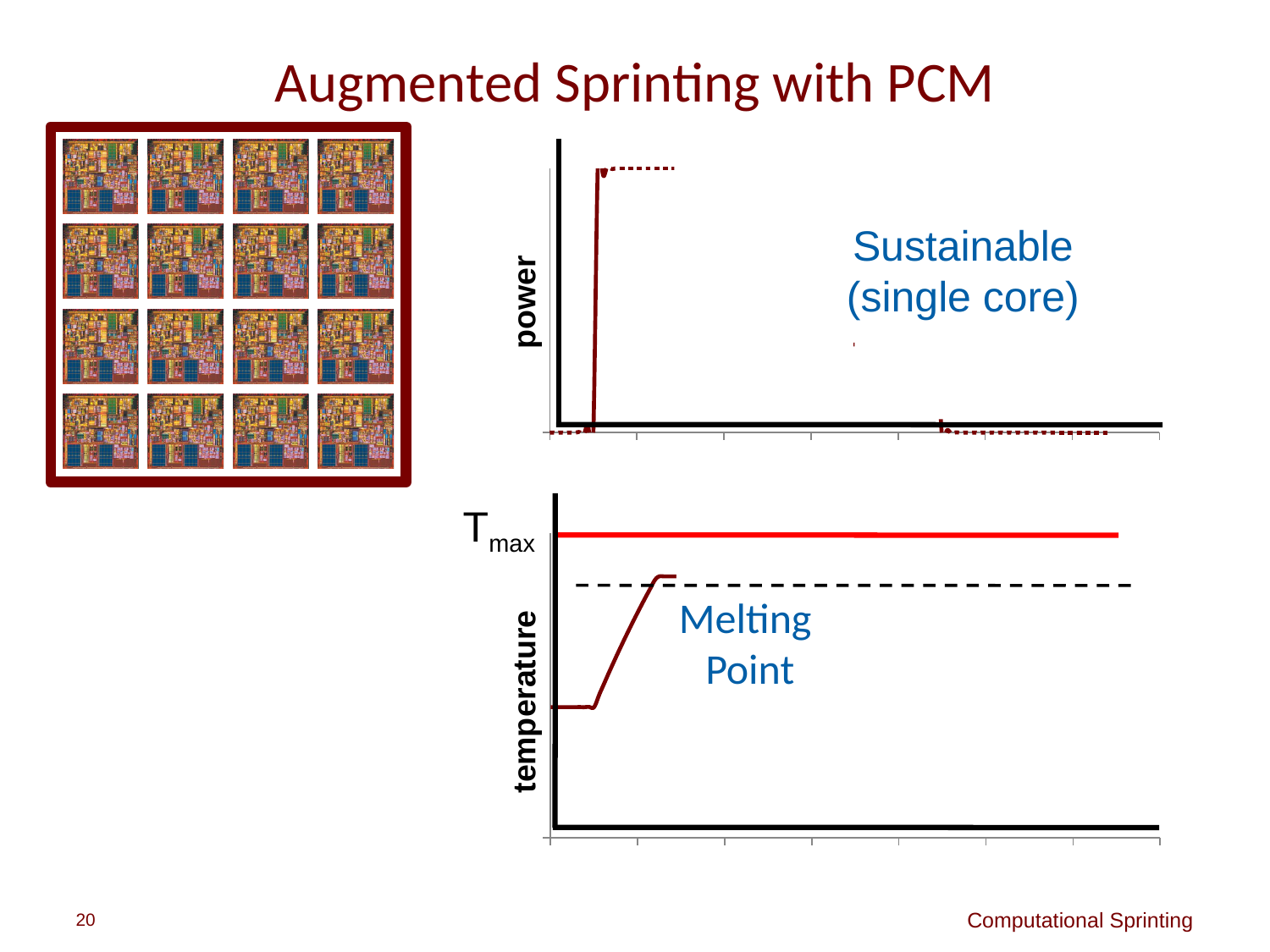
In the bottom chart, at which level does the temperature curve stop rising and level off? Melting Point In the bottom chart, does the temperature curve rise or fall after its initial flat segment? rise In the top chart, does the power curve rise or fall at the start of the plotted period? rise In the bottom chart, is the dashed 'Melting Point' line above or below the solid red Tmax line? below What kind of chart is the bottom chart on the slide? line chart What kind of chart is the top chart on the slide? line chart What is the y-axis label of the bottom chart? temperature How many charts are shown on the slide? 2 What is the y-axis label of the top chart? power In the top chart, what label is given to the lower power level shown on the right side? Sustainable (single core) In the bottom chart, what label is shown on the solid red horizontal line? Tmax